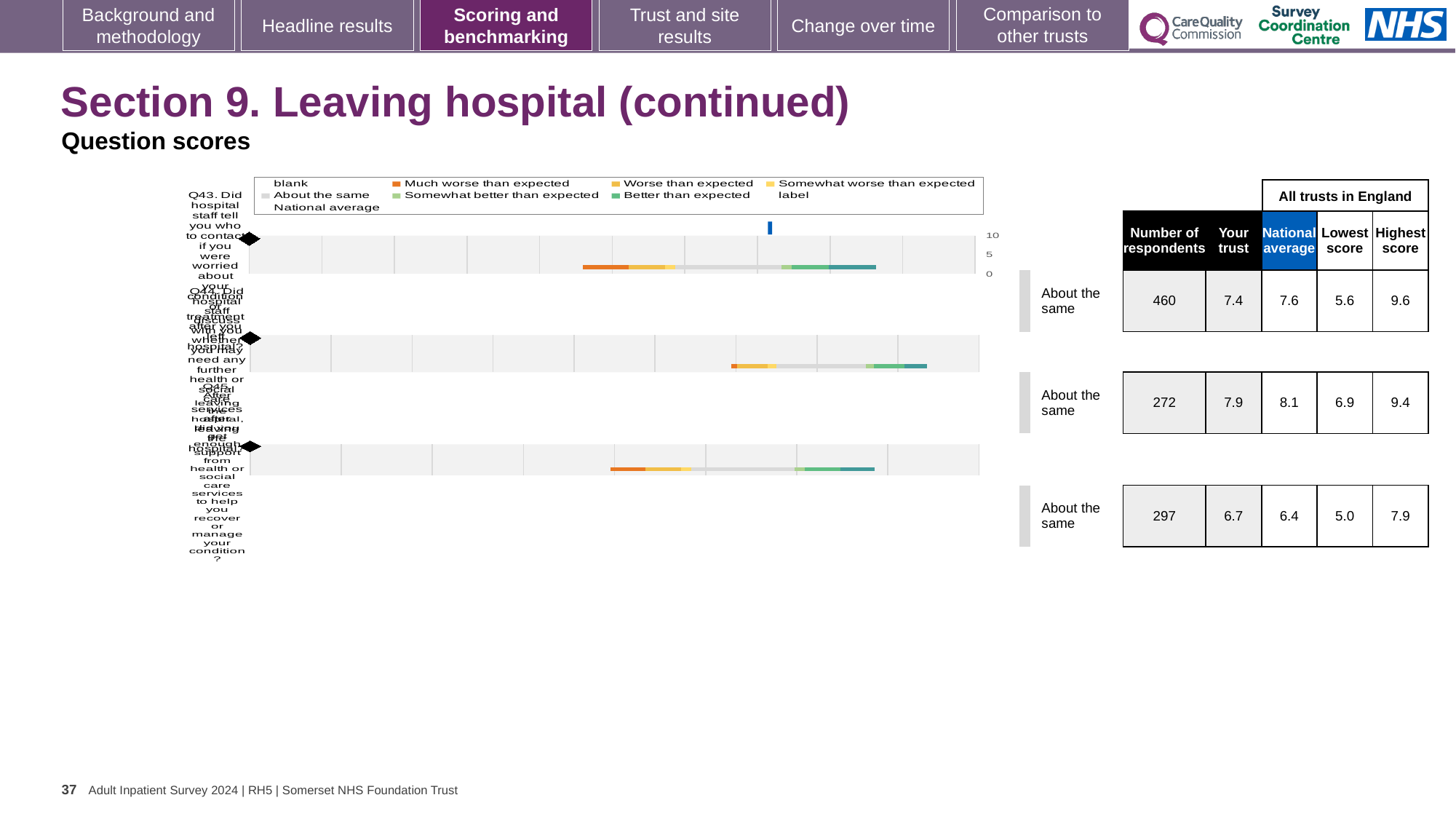
Which question has the lowest national average score? Q45 How many questions (rows) are plotted in the question scores chart? 3 What is the total number of respondents across Q43, Q44 and Q45? 1029 For Q45, what is the difference between the highest score and the lowest score among all trusts in England? 2.9 For Q43, which is larger: the 'Your trust' score or the national average? National average What kind of chart is used to show the question scores on this slide? bar chart What is the 'Your trust' score for Q43? 7.4 Which question has the highest 'Your trust' score? Q44 How many respondents are listed for Q44? 272 What benchmark category is shown for Q45? About the same What is the highest score among all trusts in England for Q43? 9.6 What is the maximum value shown on the chart's score axis? 10